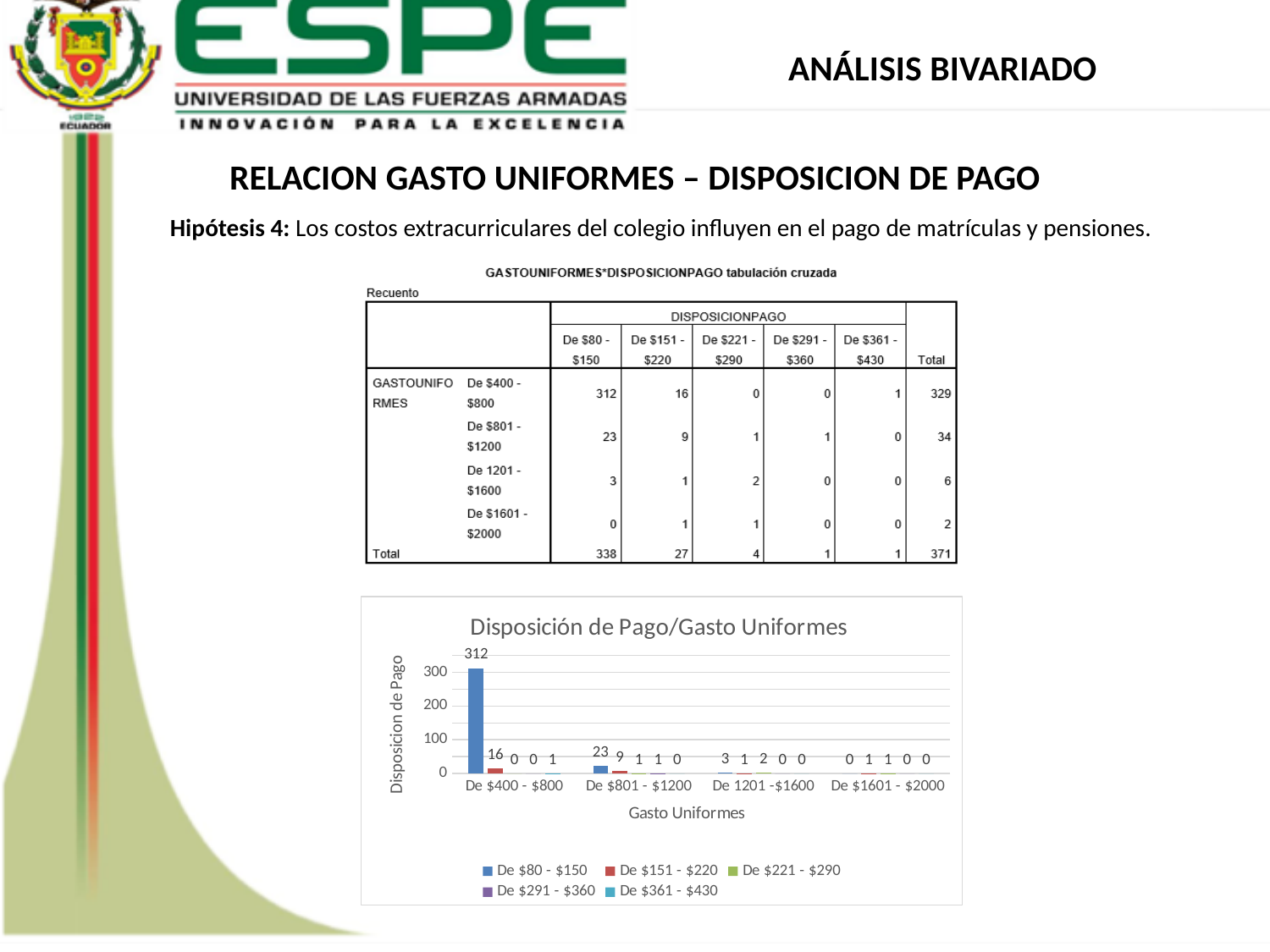
Which category has the highest value for the De $80 - $150 series? De $400 - $800 What is the difference between the De $80 - $150 values for De $400 - $800 and De $801 - $1200? 289 What kind of chart is shown on the slide? bar chart What is the value of the De $151 - $220 series for the De $801 - $1200 category? 9 Which is larger: the De $151 - $220 value for De $400 - $800 or for De $801 - $1200? De $400 - $800 What is the label of the y axis of the chart? Disposicion de Pago How many series does the chart legend list? 5 What is the value of the De $80 - $150 series for the De $400 - $800 category? 312 What is the title of the chart on the slide? Disposición de Pago/Gasto Uniformes Is the De $80 - $150 value for De $400 - $800 greater or less than 300? greater What is the value of the De $221 - $290 series for the De 1201 - $1600 category? 2 How many categories are shown on the x axis of the chart? 4